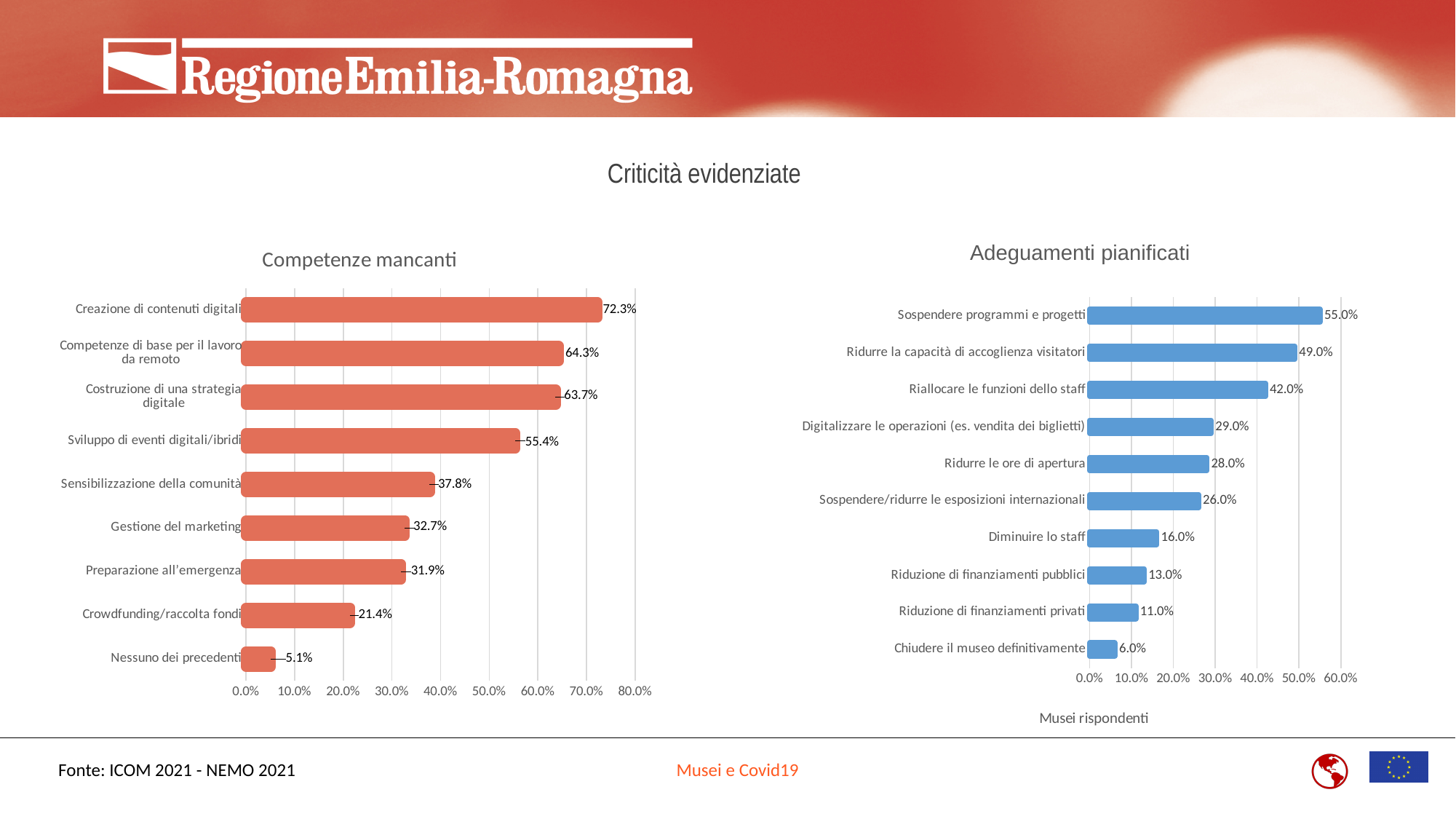
What is the x-axis title of the 'Adeguamenti pianificati' chart? Musei rispondenti In the 'Adeguamenti pianificati' chart, what is the value for 'Riallocare le funzioni dello staff'? 42.0% In the 'Competenze mancanti' chart, what is the value for 'Creazione di contenuti digitali'? 72.3% In the 'Adeguamenti pianificati' chart, how many categories are shown? 10 In the 'Adeguamenti pianificati' chart, which is larger: 'Diminuire lo staff' or 'Riduzione di finanziamenti pubblici'? Diminuire lo staff In the 'Competenze mancanti' chart, how many categories are shown? 9 In the 'Competenze mancanti' chart, which category has the lowest value? Nessuno dei precedenti In the 'Competenze mancanti' chart, what is the difference between 'Sviluppo di eventi digitali/ibridi' and 'Sensibilizzazione della comunità'? 17.6% In the 'Adeguamenti pianificati' chart, which category has the highest value? Sospendere programmi e progetti In the 'Adeguamenti pianificati' chart, what is the difference between 'Sospendere programmi e progetti' and 'Ridurre la capacità di accoglienza visitatori'? 6.0% What kind of chart is the 'Adeguamenti pianificati' chart? Bar chart In the 'Competenze mancanti' chart, what is the value for 'Crowdfunding/raccolta fondi'? 21.4%